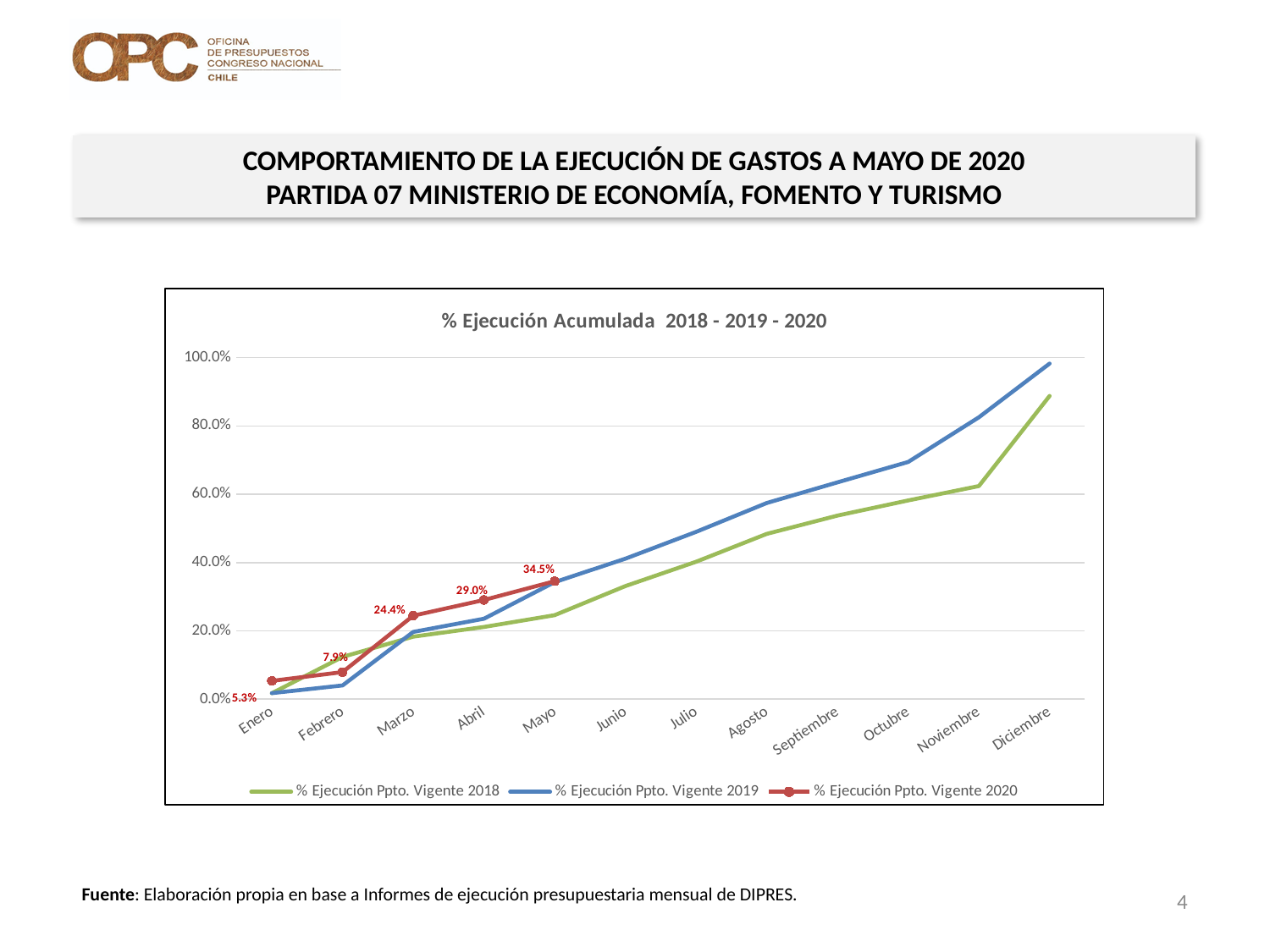
What is the difference between the 2020 values for Marzo and Febrero? 16.5% How many series does the legend list? 3 What is the value of % Ejecución Ppto. Vigente 2020 for Mayo? 34.5% How many months are shown on the x axis? 12 What is the value of % Ejecución Ppto. Vigente 2020 for Enero? 5.3% What is the difference between the 2020 values for Mayo and Abril? 5.5% In which month does the % Ejecución Ppto. Vigente 2020 series reach its highest value? Mayo Which series has the higher value in Diciembre, 2018 or 2019? % Ejecución Ppto. Vigente 2019 What is the value of % Ejecución Ppto. Vigente 2020 for Abril? 29.0% What kind of chart is shown? Line chart What is the value of % Ejecución Ppto. Vigente 2020 for Marzo? 24.4% Is the value for % Ejecución Ppto. Vigente 2018 in Noviembre greater or less than 80.0%? less